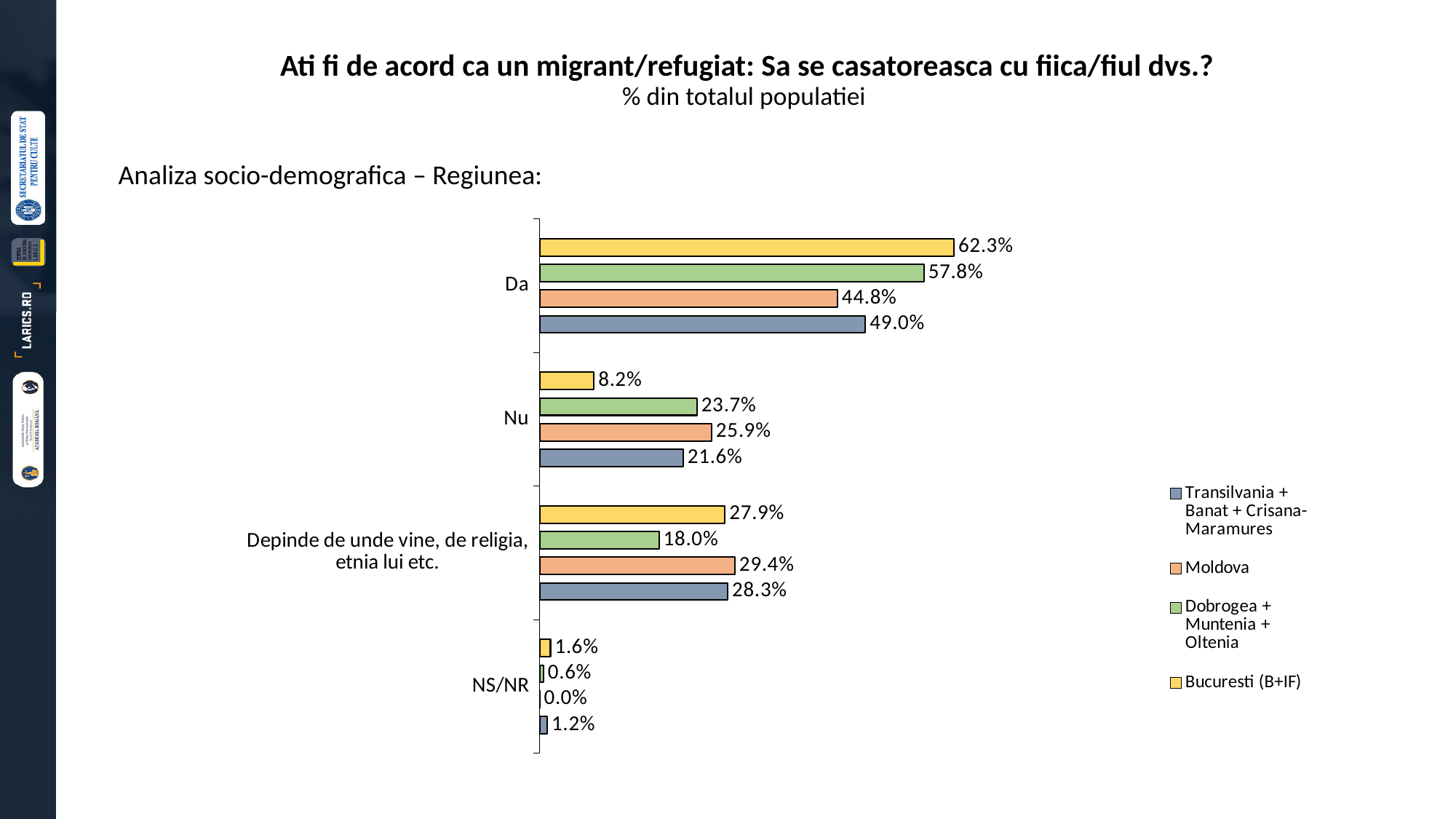
What is the value for Bucuresti (B+IF) in the "Da" category? 62.3% Which region has the lowest value in the "Depinde de unde vine, de religia, etnia lui etc." category? Dobrogea + Muntenia + Oltenia Which region has the lowest value in the "Nu" category? Bucuresti (B+IF) In the "Nu" category, which is larger: the value for Dobrogea + Muntenia + Oltenia or the value for Transilvania + Banat + Crisana-Maramures? Dobrogea + Muntenia + Oltenia How many response categories are shown on the chart? 4 What kind of chart is shown on the slide? Bar chart Which region has the highest value in the "Da" category? Bucuresti (B+IF) How many series does the legend list? 4 What is the difference between the Bucuresti (B+IF) and Moldova values in the "Da" category? 17.5% What is the value for Transilvania + Banat + Crisana-Maramures in the "Depinde de unde vine, de religia, etnia lui etc." category? 28.3% What is the value for Moldova in the "Nu" category? 25.9% What is the value for Dobrogea + Muntenia + Oltenia in the "NS/NR" category? 0.6%